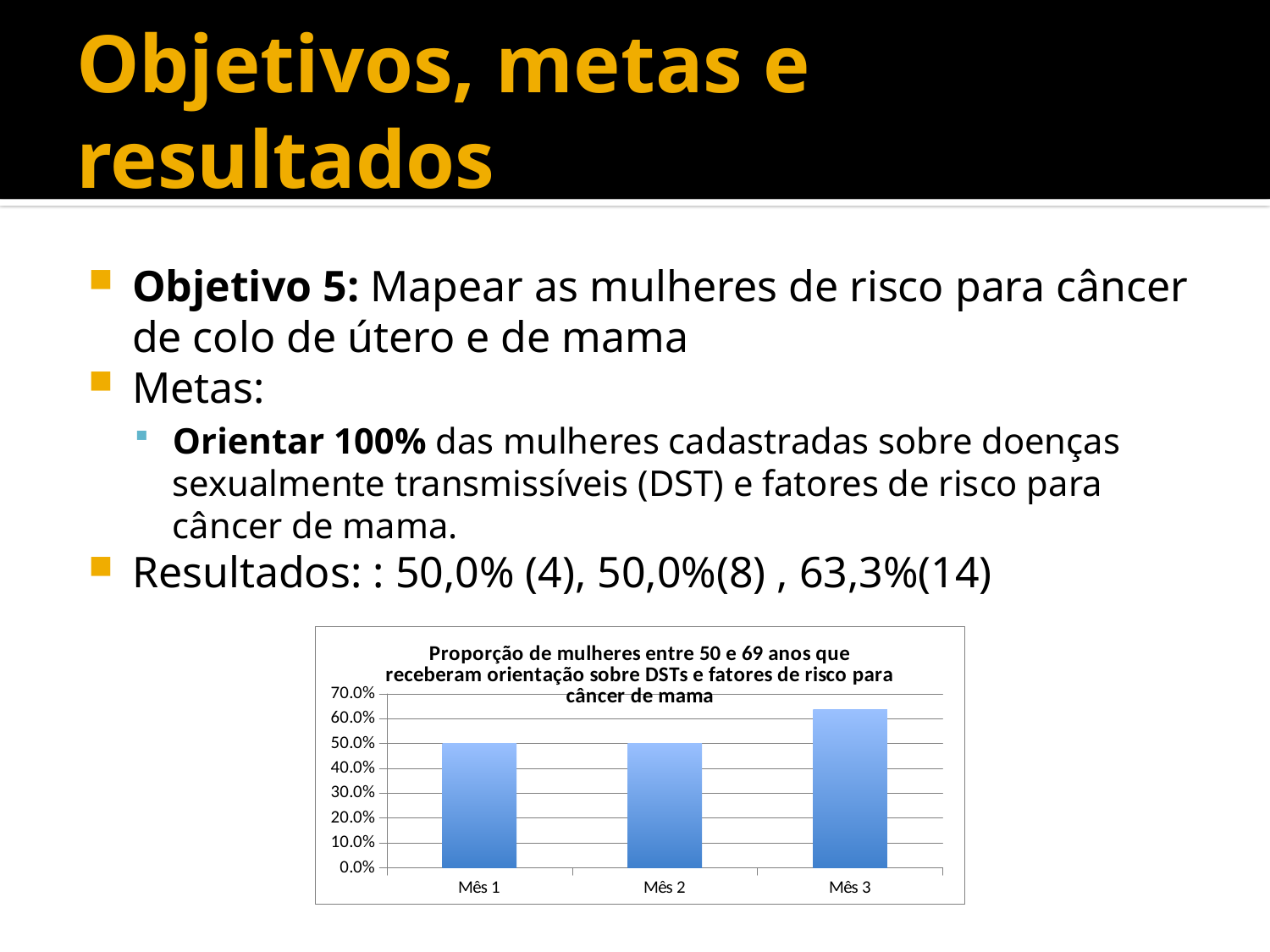
What is the value for Mês 1? 50.0% Is the value for Mês 3 greater or less than 70.0%? less Do the values rise or fall from Mês 1 to Mês 3? rise Is the value for Mês 1 greater or less than 60.0%? less What type of chart is shown on the slide? bar chart What is the title of the chart? Proporção de mulheres entre 50 e 69 anos que receberam orientação sobre DSTs e fatores de risco para câncer de mama What is the value for Mês 2? 50.0% Which month has the highest value? Mês 3 What is the highest value shown on the vertical axis of the chart? 70.0% Is the value for Mês 3 greater or less than 60.0%? greater How many categories (months) are plotted on the chart? 3 Which is larger, the value for Mês 1 or the value for Mês 3? Mês 3